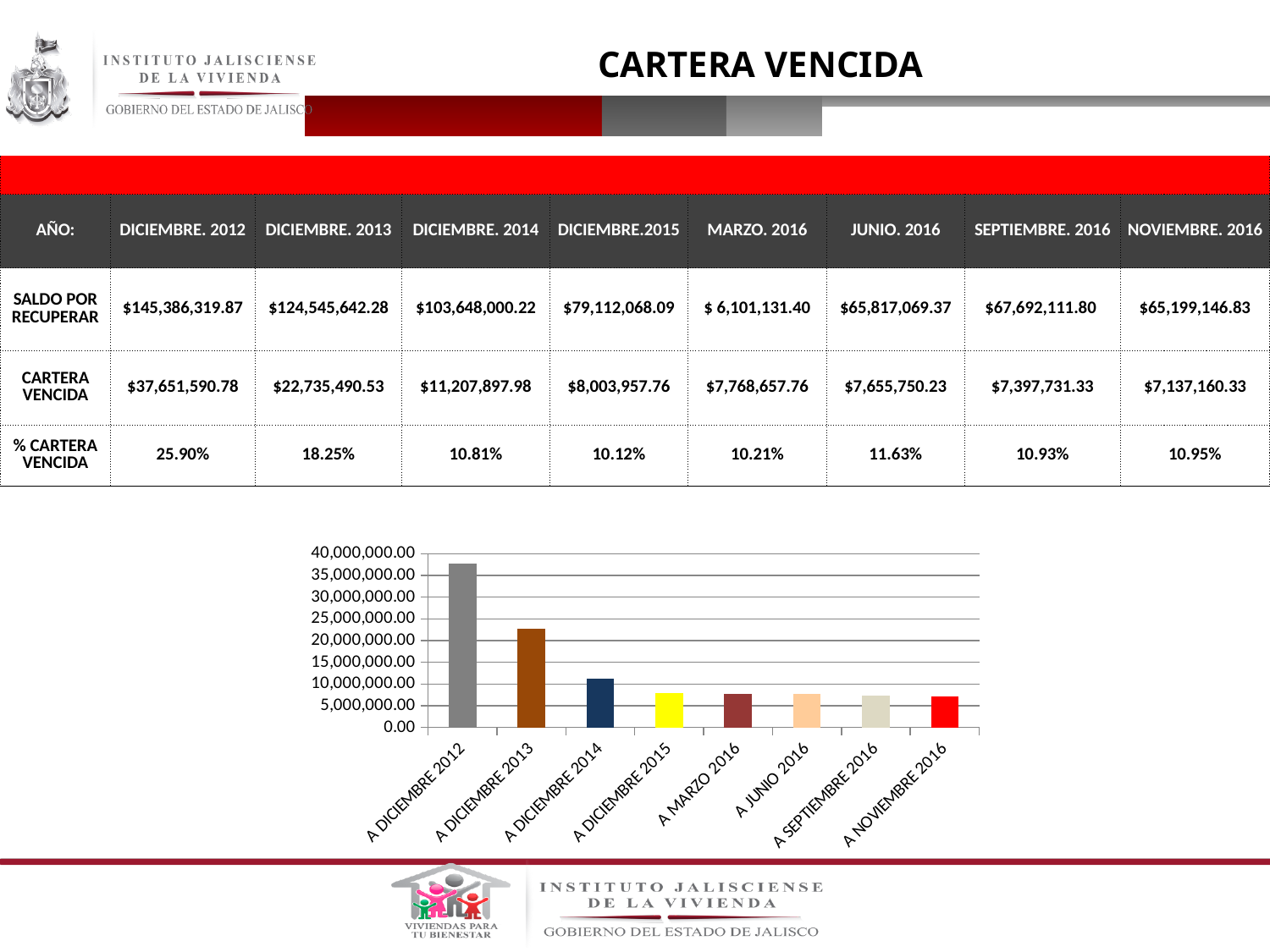
Which category has the highest bar in the chart? A DICIEMBRE 2012 Using the table values, what is the difference between the CARTERA VENCIDA for DICIEMBRE. 2012 and DICIEMBRE. 2013? $14,916,100.25 According to the table, what is the CARTERA VENCIDA value for NOVIEMBRE. 2016, the value plotted in the last bar? $7,137,160.33 Is the bar for A NOVIEMBRE 2016 greater or less than 10,000,000.00? less Do the bar values generally rise or fall from A DICIEMBRE 2012 to A NOVIEMBRE 2016? fall What kind of chart is shown on the slide? bar chart Is the bar for A DICIEMBRE 2012 greater or less than 35,000,000.00? greater Is the bar for A DICIEMBRE 2013 greater or less than 20,000,000.00? greater According to the table, what is the CARTERA VENCIDA value for DICIEMBRE. 2012, the value plotted in the first bar? $37,651,590.78 How many bars (categories) does the chart show? 8 Which bar is taller, A DICIEMBRE 2013 or A DICIEMBRE 2014? A DICIEMBRE 2013